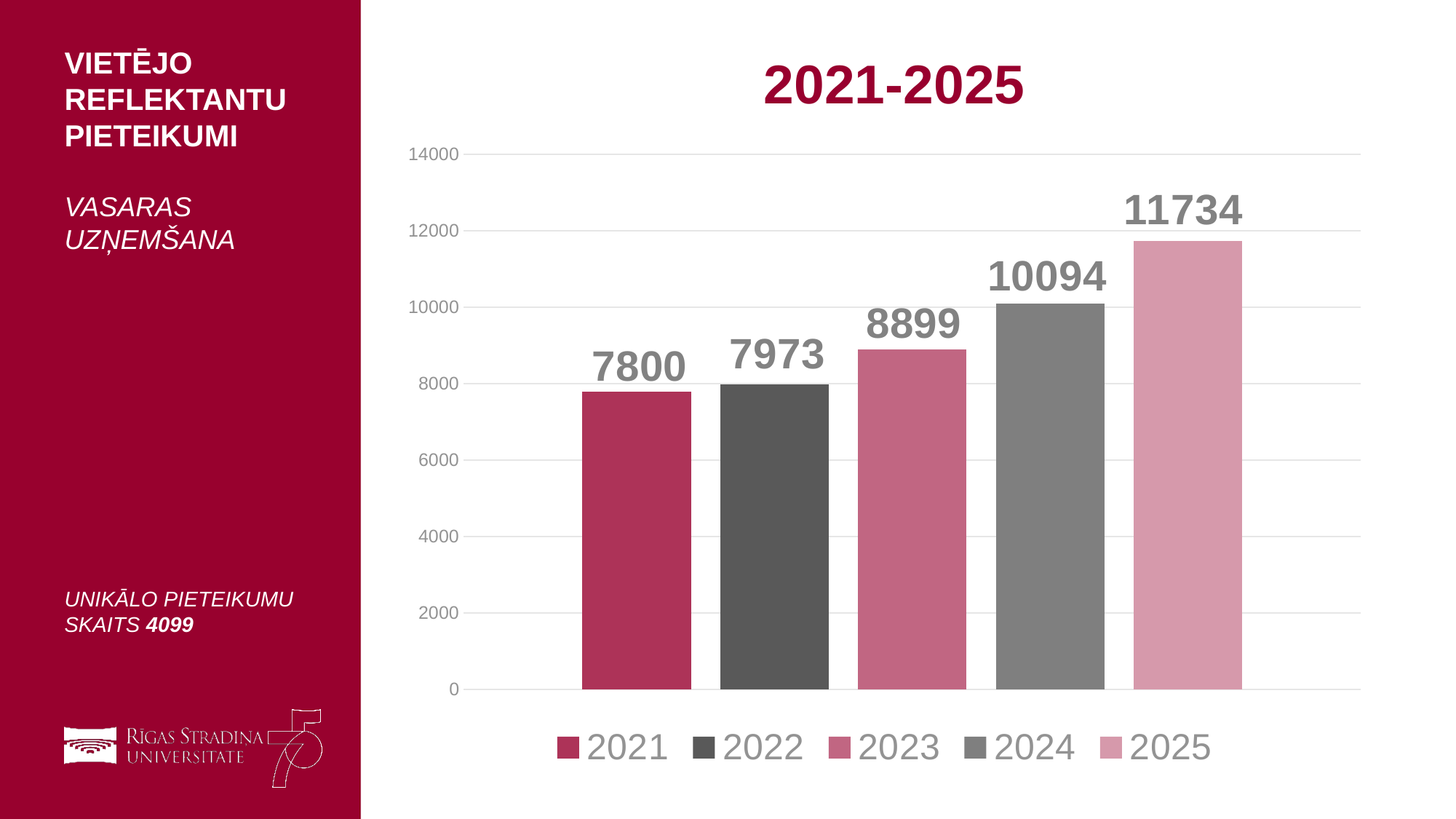
What kind of chart is shown on the slide? bar chart Which year has the highest value? 2025 What is the difference between the values for 2025 and 2024? 1640 Is the value for 2024 greater or less than 10000? greater Which is larger, the value for 2023 or the value for 2024? 2024 Do the values rise or fall from 2021 to 2025? rise What is the value for 2025? 11734 What is the value for 2021? 7800 How many bars are shown in the chart? 5 What is the difference between the values for 2022 and 2021? 173 Which year has the lowest value? 2021 What is the value for 2023? 8899